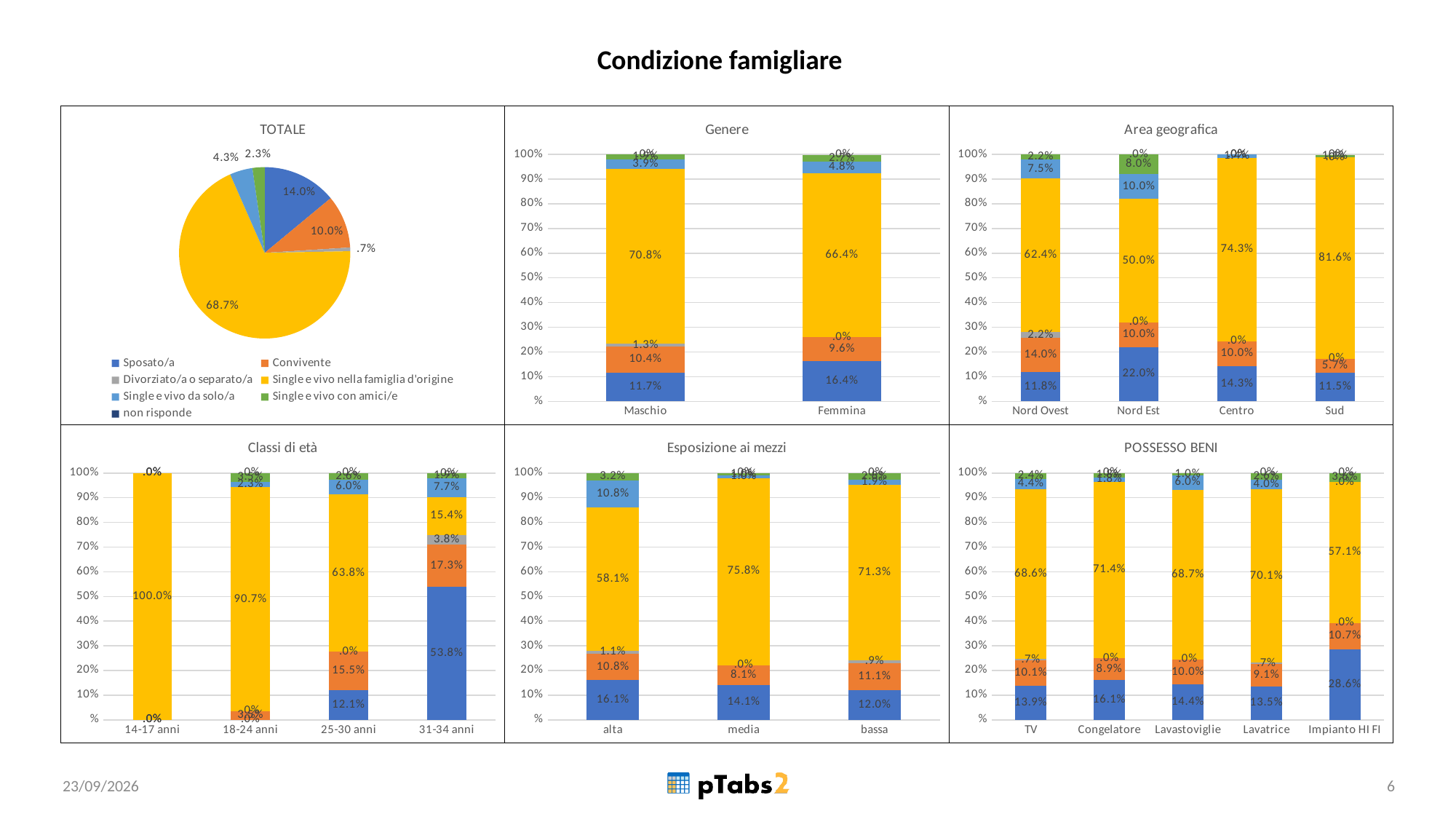
In the Esposizione ai mezzi chart, which category has the largest yellow (Single e vivo nella famiglia d'origine) segment? media In the Area geografica chart, what is the value of the blue (Sposato/a) segment for Nord Est? 22.0% How many categories are shown on the x axis of the Classi di età chart? 4 In the Genere chart, what is the value of the yellow (Single e vivo nella famiglia d'origine) segment for Maschio? 70.8% How many entries does the legend of the TOTALE chart list? 7 In the Area geografica chart, which category has the largest yellow (Single e vivo nella famiglia d'origine) segment? Sud In the Classi di età chart, what is the value of the blue (Sposato/a) segment for 31-34 anni? 53.8% In the Genere chart, what is the difference between the blue (Sposato/a) segments for Femmina and Maschio? 4.7% In the TOTALE pie chart, what share is shown for Sposato/a? 14.0% In the POSSESSO BENI chart, is the blue (Sposato/a) segment larger for Impianto HI FI or for TV? Impianto HI FI What kind of chart is the TOTALE chart? Pie chart In the TOTALE pie chart, what share is shown for Single e vivo nella famiglia d'origine? 68.7%